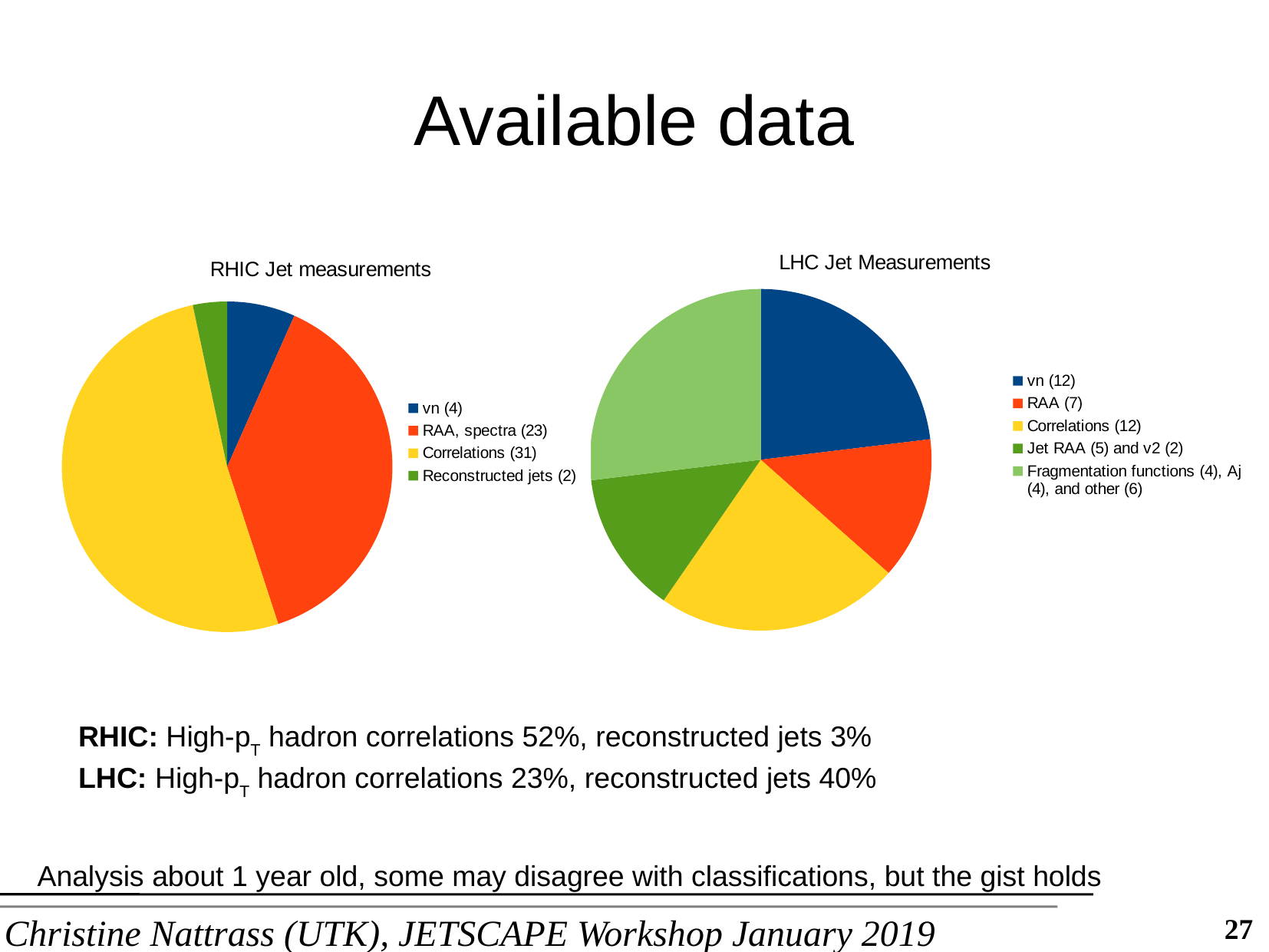
What kind of chart is the LHC Jet Measurements chart? Pie chart On the RHIC Jet measurements chart, which category has the smallest slice? Reconstructed jets (2) On the RHIC Jet measurements chart, how many measurements are listed for RAA, spectra? 23 On the RHIC Jet measurements chart, which category has the largest slice? Correlations (31) On the RHIC Jet measurements chart, what share of the pie do Correlations represent, according to the slide text? 52% On the RHIC Jet measurements chart, what is the difference between the Correlations count and the RAA, spectra count? 8 On the LHC Jet Measurements chart, how many measurements are listed for vn? 12 How many categories does the LHC Jet Measurements chart have? 5 How many categories does the RHIC Jet measurements chart have? 4 On the LHC Jet Measurements chart, which is larger, vn or RAA? vn On the LHC Jet Measurements chart, how many measurements are listed for RAA? 7 On the RHIC Jet measurements chart, how many measurements are listed for Correlations? 31